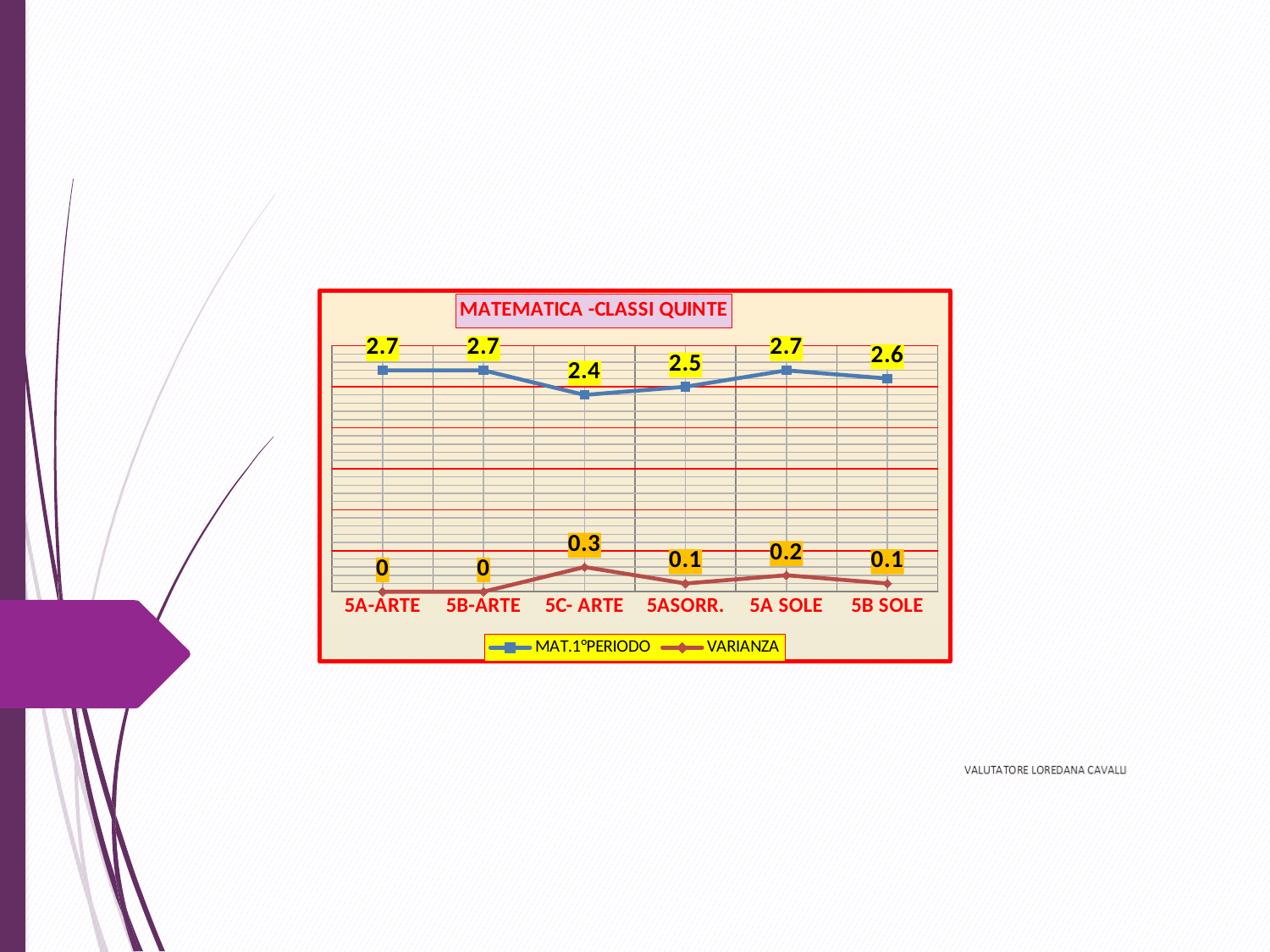
What kind of chart is shown? line chart How many series does the legend list? 2 What is the VARIANZA value for 5B-ARTE? 0 What is the title of the chart? MATEMATICA -CLASSI QUINTE What is the MAT.1°PERIODO value for 5B SOLE? 2.6 Which category has the lowest MAT.1°PERIODO value? 5C- ARTE What is the VARIANZA value for 5A SOLE? 0.2 Which category has the highest VARIANZA value? 5C- ARTE What is the MAT.1°PERIODO value for 5C- ARTE? 2.4 How many categories are shown on the x axis? 6 What is the difference between the MAT.1°PERIODO values for 5A-ARTE and 5C- ARTE? 0.3 Which is larger, the MAT.1°PERIODO value for 5ASORR. or for 5B SOLE? 5B SOLE